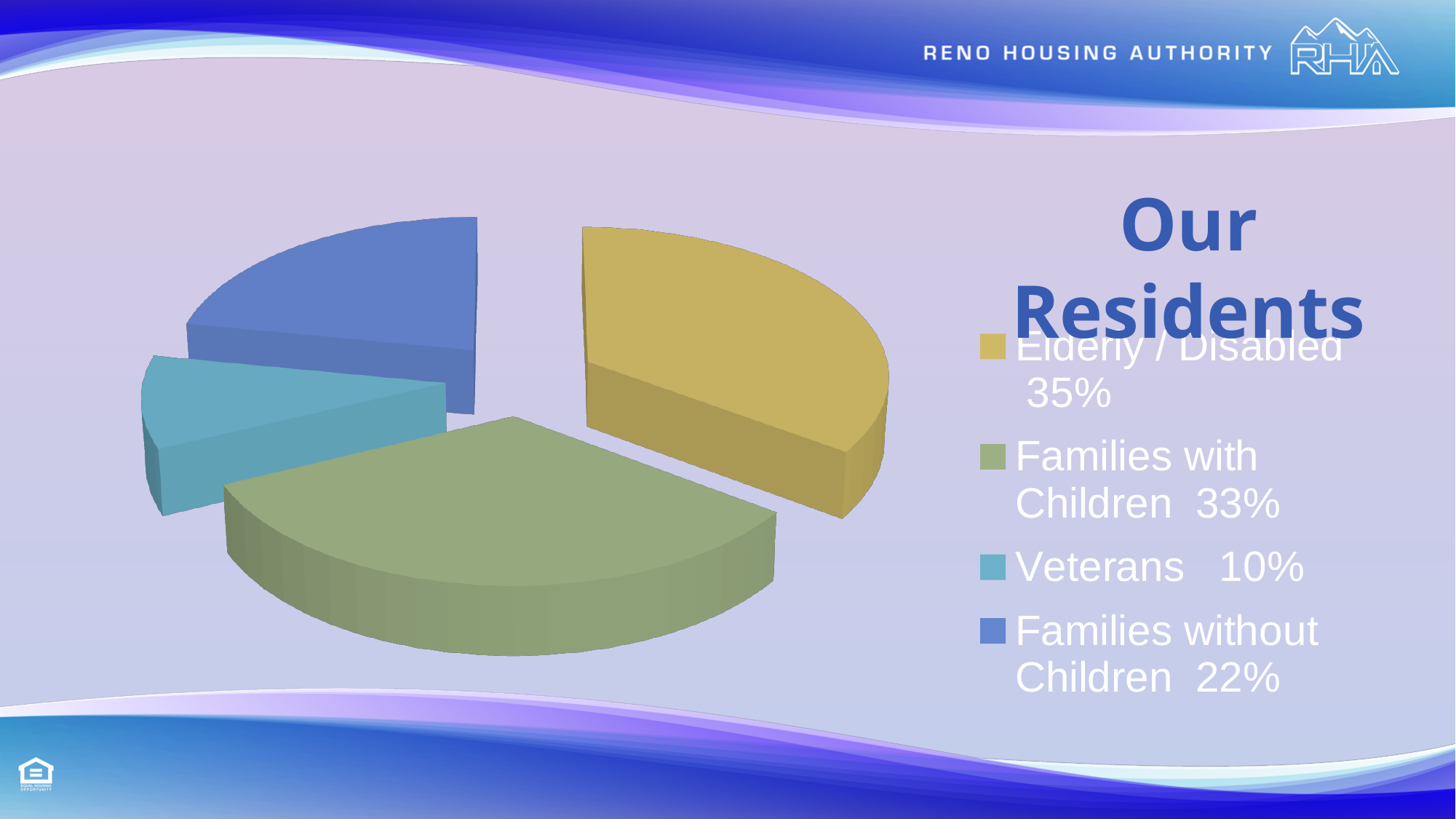
What percentage of residents are Elderly / Disabled? 35% What is the title of the chart on the slide? Our Residents How many categories does the pie chart show? 4 Which is larger, the share for Families without Children or the share for Veterans? Families without Children Which resident category has the largest share of the pie? Elderly / Disabled What percentage of residents are Families with Children? 33% What is the difference in percentage points between Families without Children and Veterans? 12 What colour is the Veterans slice in the pie chart? teal / light blue What percentage of residents are Families without Children? 22% What kind of chart is shown on the slide? pie chart Which resident category has the smallest share of the pie? Veterans What percentage of residents are Veterans? 10%